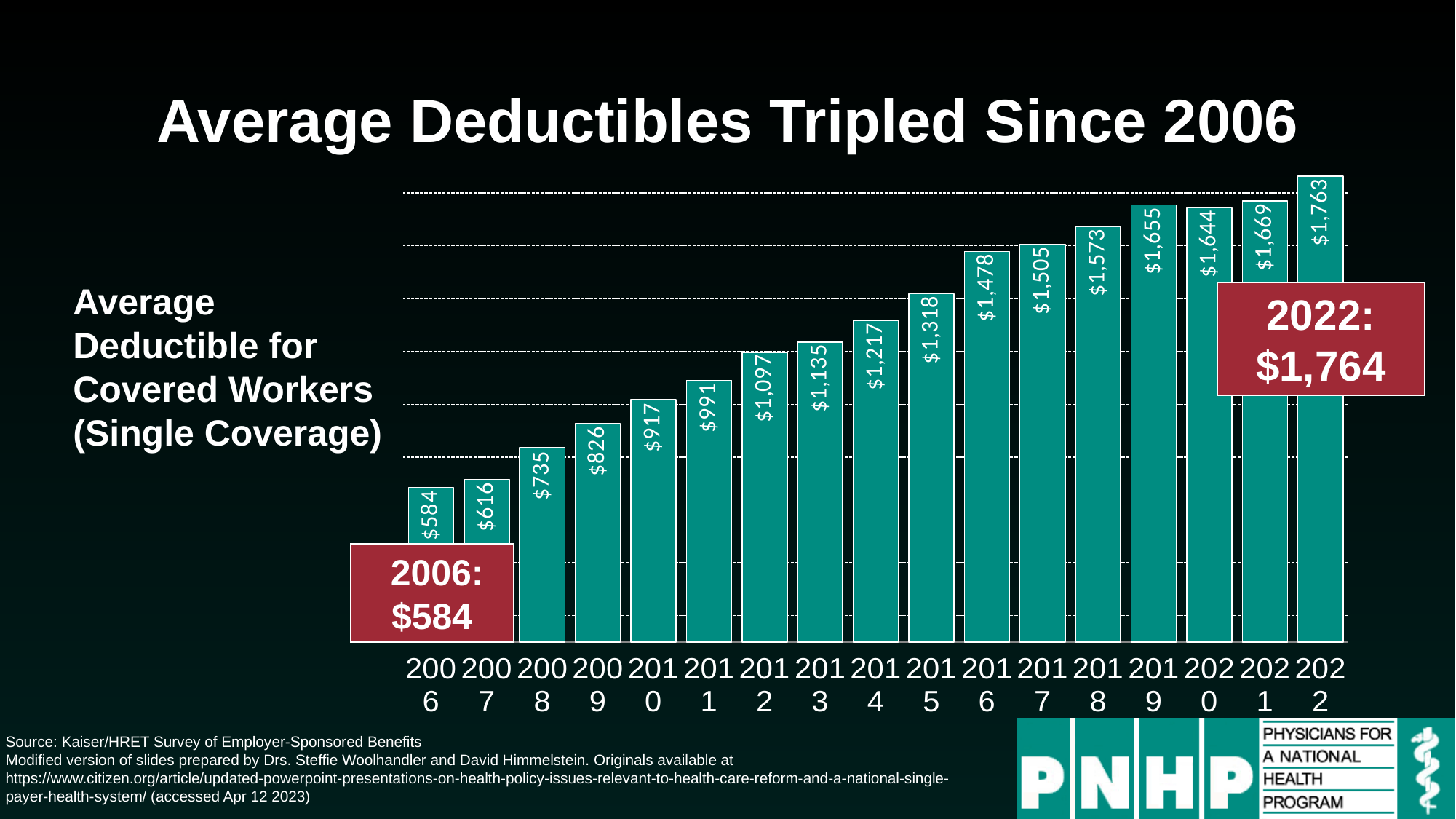
What is the average deductible shown for 2010? $917 What is the average deductible shown for 2006? $584 Which year has the lowest average deductible? 2006 Which year has the highest average deductible? 2022 Do the average deductibles generally rise or fall from 2006 to 2022? Rise What is the average deductible shown for 2019? $1,655 What is the difference between the 2019 and 2020 average deductibles? $11 How many years are plotted in the chart? 17 By how much did the average deductible increase from 2006 to 2007? $32 What is the average deductible shown for 2014? $1,217 Which year has the larger average deductible, 2019 or 2020? 2019 What kind of chart is shown on the slide? Bar chart